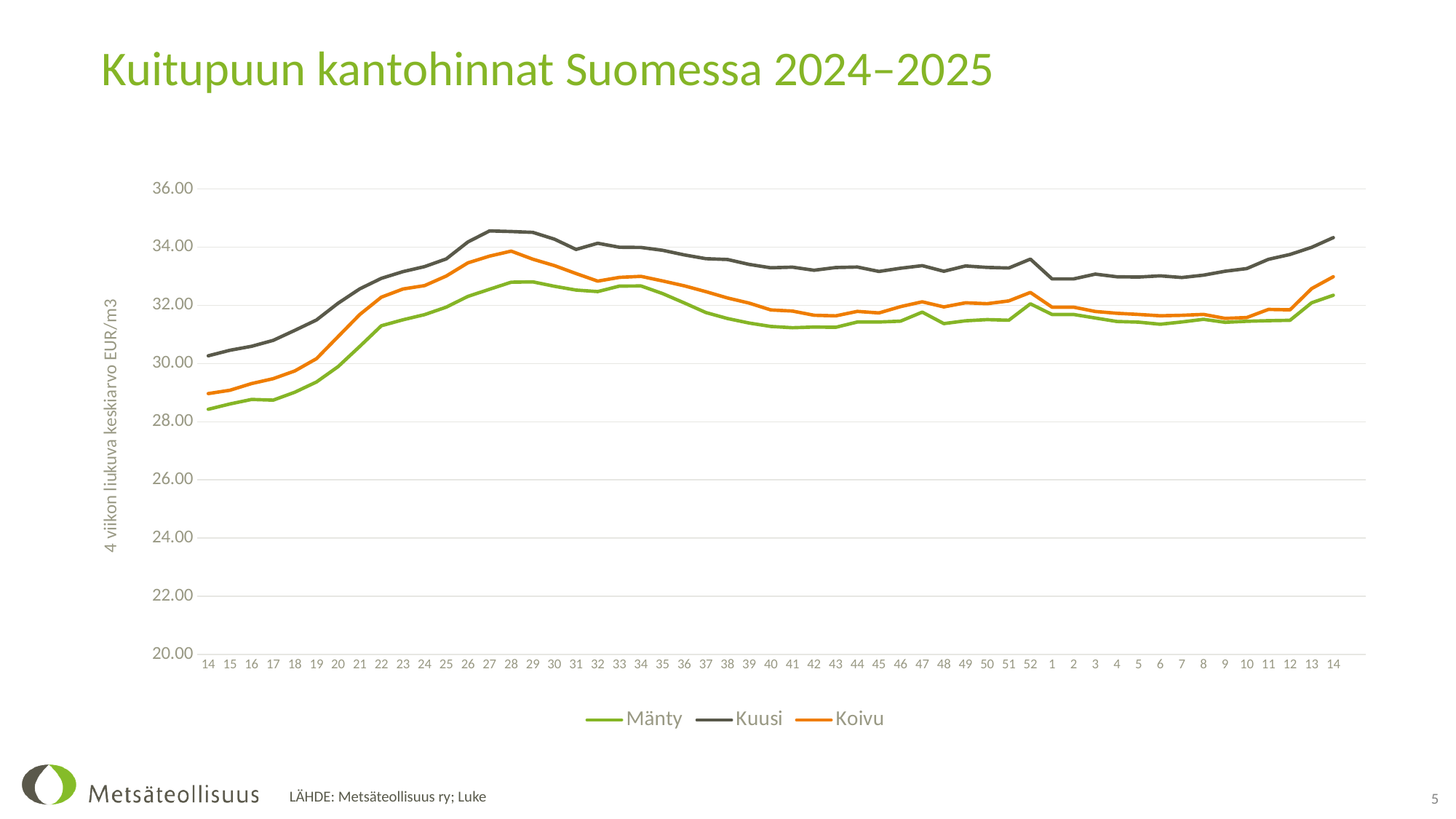
Is the value for Mänty at week 40 greater or less than 32.00? less What is the title of the chart? Kuitupuun kantohinnat Suomessa 2024–2025 Is the value for Kuusi at week 27 greater or less than 34.00? greater How many series does the legend list? 3 At week 14, which is larger, the value for Kuusi or the value for Koivu? Kuusi Which series has the lowest value at week 40? Mänty Is the value for Kuusi at week 1 greater or less than 34.00? less How many week labels are shown along the x axis? 53 Which series has the highest value at week 28? Kuusi Does the Mänty line rise or fall from week 14 to week 27? rise What kind of chart is shown on the slide? line chart